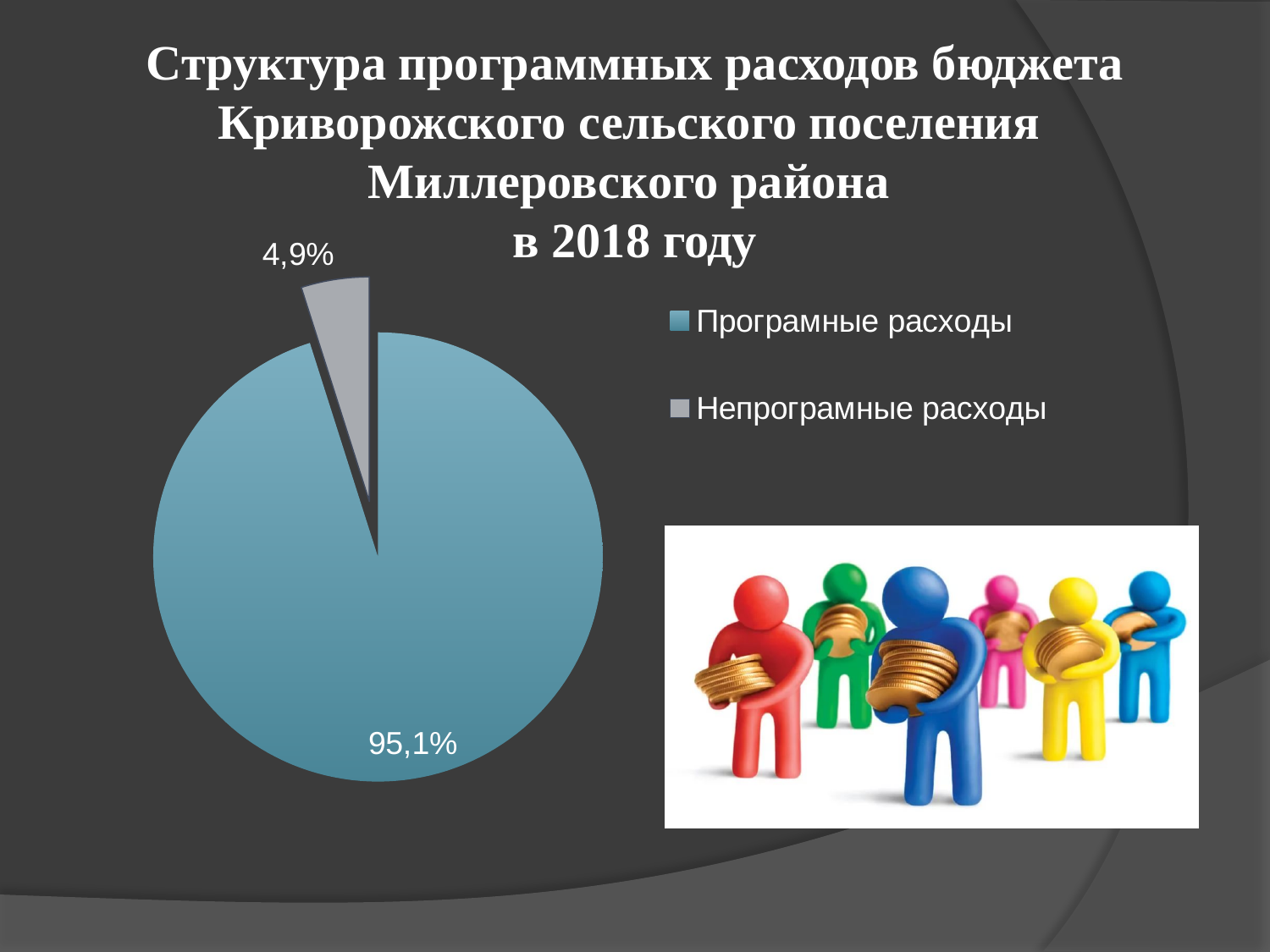
Which year does the chart title refer to? 2018 Which is larger, the share for "Програмные расходы" or for "Непрограмные расходы"? Програмные расходы Which category has the smallest slice of the pie? Непрограмные расходы Which category has the largest slice of the pie? Програмные расходы What share of the pie does "Програмные расходы" take? 95,1% What share of the pie does "Непрограмные расходы" take? 4,9% What colour is the slice for "Непрограмные расходы"? grey What is the difference in percentage points between "Програмные расходы" and "Непрограмные расходы"? 90,2 How many slices does the pie chart have? 2 What kind of chart is shown on the slide? pie chart How many entries does the legend list? 2